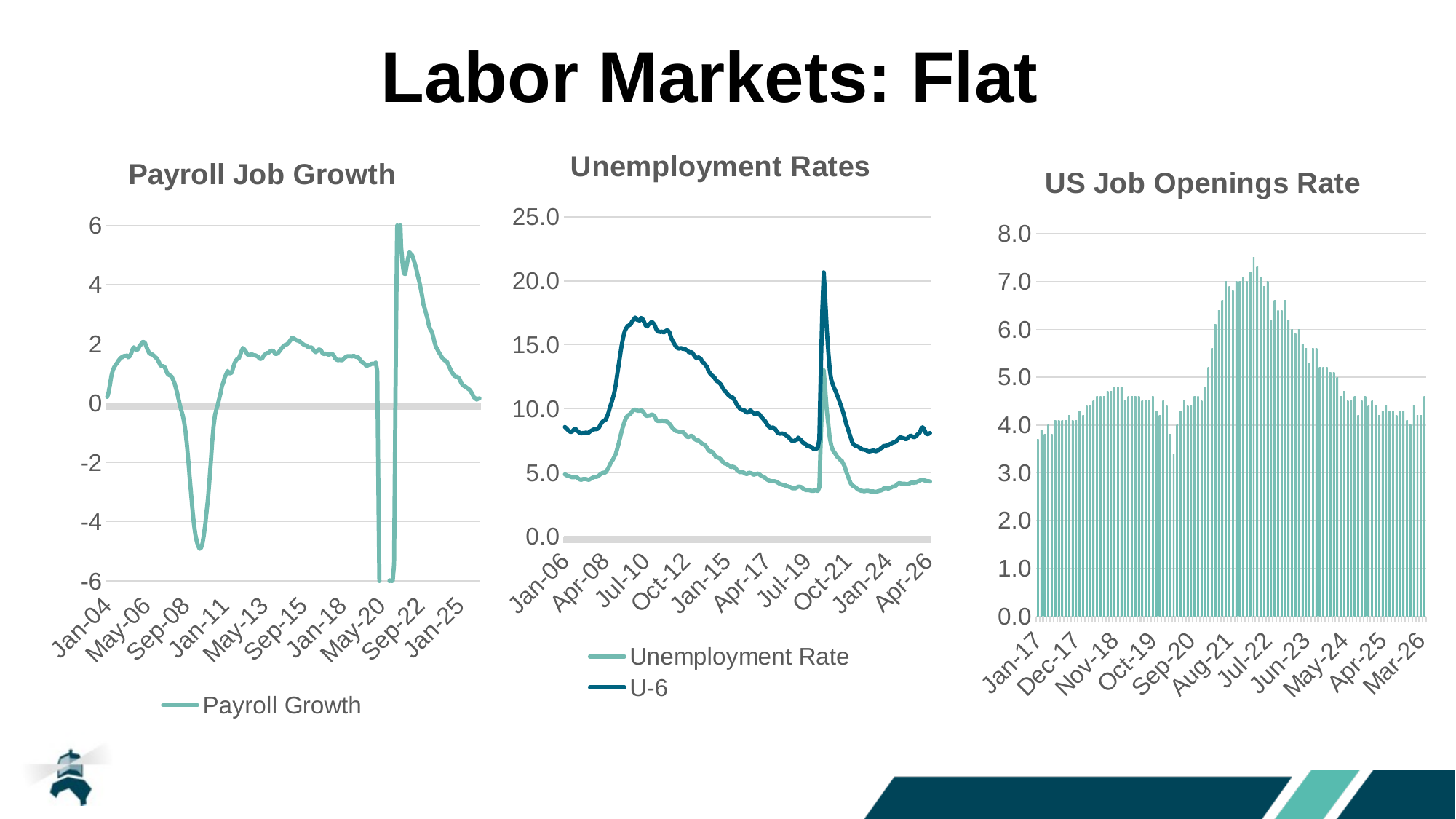
In the Unemployment Rates chart, is the peak of the U-6 series around 2020 greater or less than 15.0? greater In the US Job Openings Rate chart, do the bars rise or fall from Jul-22 to Mar-26? fall In the Unemployment Rates chart, which series is higher throughout the period, U-6 or Unemployment Rate? U-6 What are the two legend entries on the Unemployment Rates chart? Unemployment Rate and U-6 In the Payroll Job Growth chart, is the lowest point around 2020 greater or less than -4? less What kind of chart is the Payroll Job Growth chart? line chart In the Unemployment Rates chart, does the Unemployment Rate rise or fall between Jul-10 and Jul-19? fall How many series does the legend of the Unemployment Rates chart list? 2 In the US Job Openings Rate chart, is the highest bar around 2022 greater or less than 7.0? greater What kind of chart is the US Job Openings Rate chart? bar chart What is the legend entry on the Payroll Job Growth chart? Payroll Growth